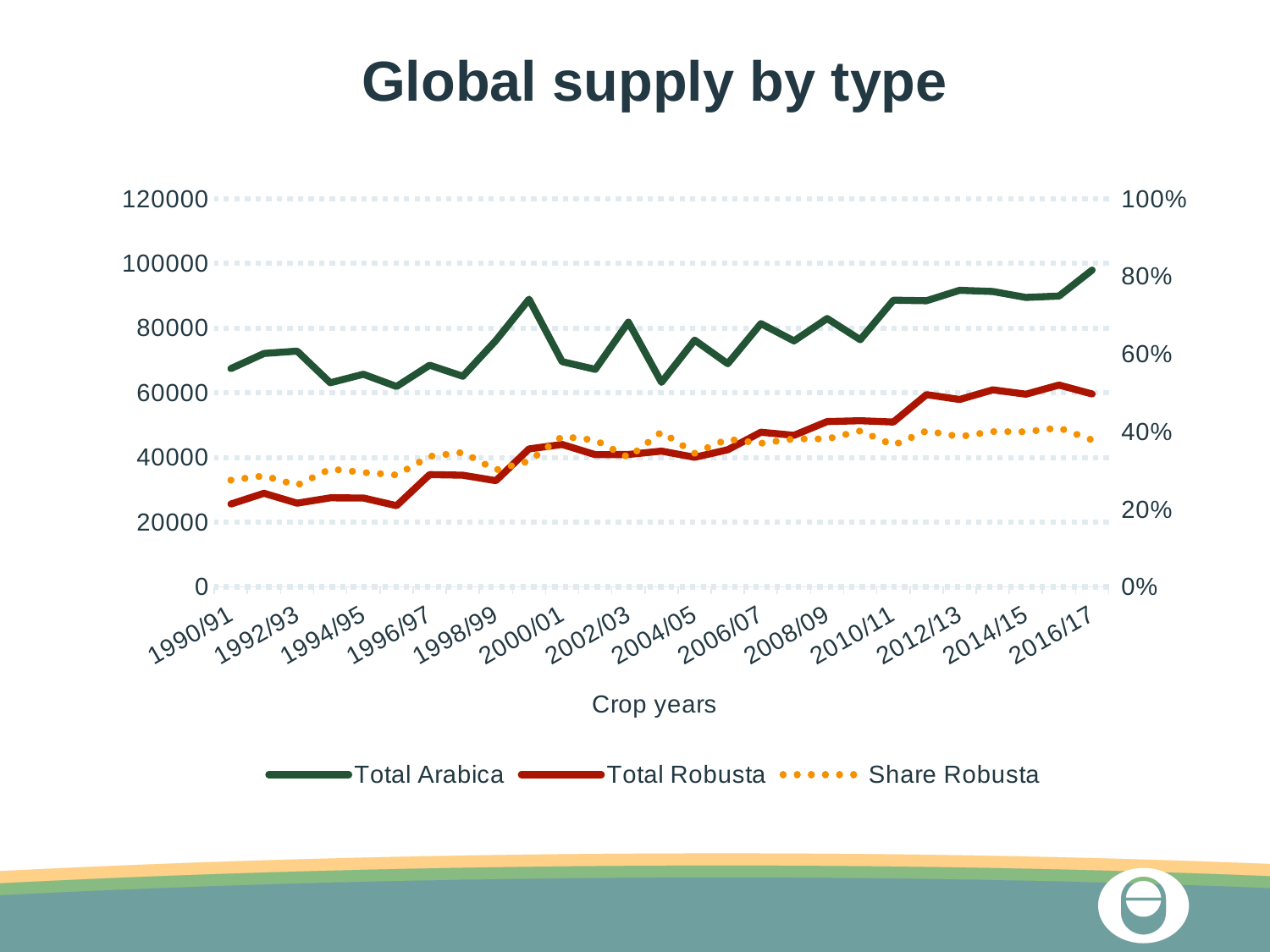
How many series does the legend list? 3 In which crop year is Total Arabica highest? 2016/17 Is the value for Total Arabica in 2016/17 greater or less than 80000? greater Does Total Robusta generally rise or fall from 1990/91 to 2016/17? rise Is the value for Share Robusta in 2016/17 greater or less than 60%? less What kind of chart is shown on the slide? line chart Is the value for Total Robusta in 1990/91 greater or less than 40000? less What is the title of the x axis? Crop years What is the title of the chart? Global supply by type In 2016/17, which is larger, Total Arabica or Total Robusta? Total Arabica